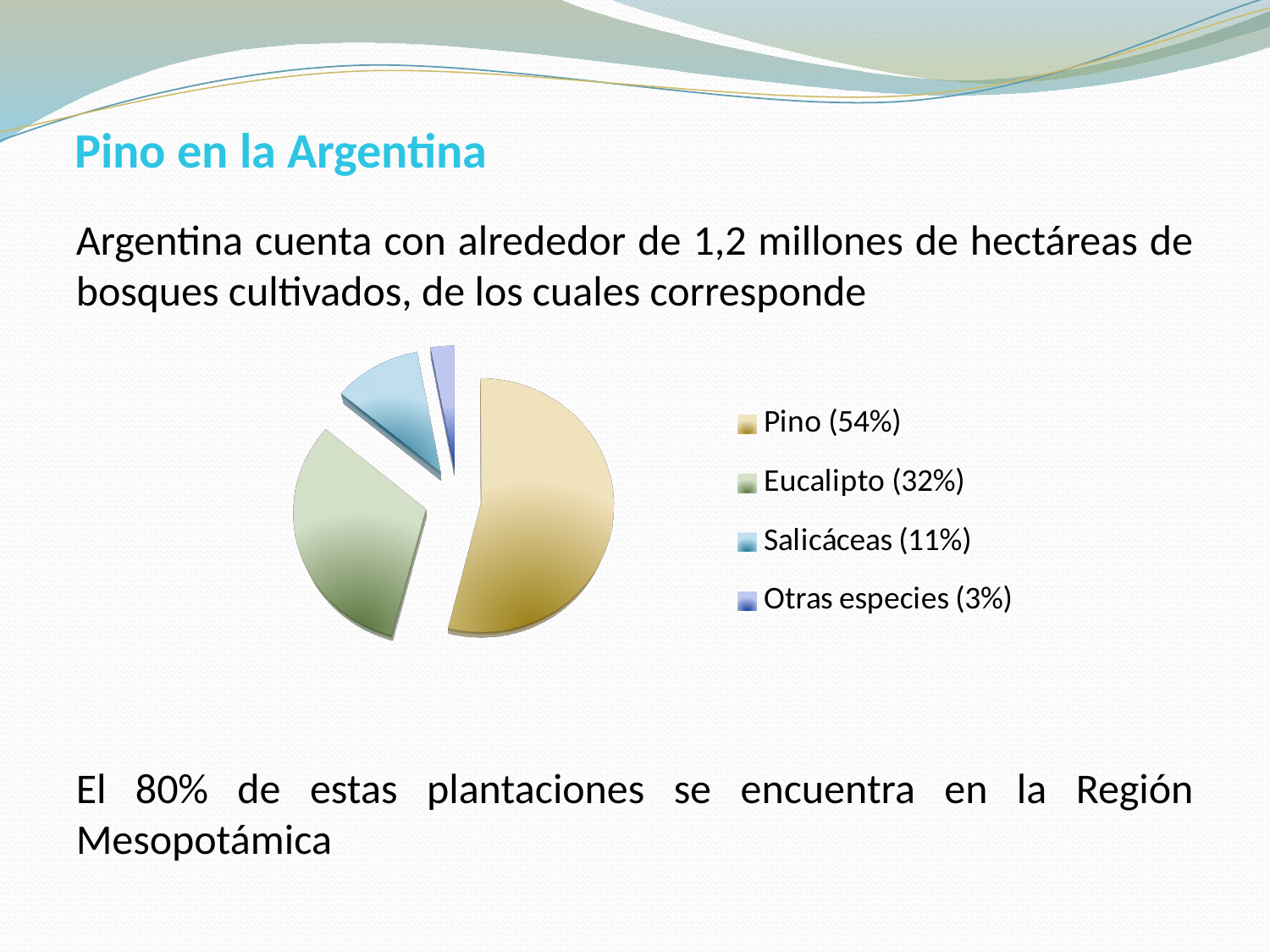
What share of the pie does Pino represent? 54% What kind of chart is shown on the slide? pie chart What colour is the Pino slice in the pie chart? yellow/tan What is the difference in percentage points between Pino and Eucalipto? 22 What share of the pie does Salicáceas represent? 11% What is the combined share of Salicáceas and Otras especies? 14% How many slices does the pie chart have? 4 Which category has the smallest slice of the pie? Otras especies Which is larger, the share for Eucalipto or the share for Salicáceas? Eucalipto What share of the pie does Eucalipto represent? 32% Which category has the largest slice of the pie? Pino